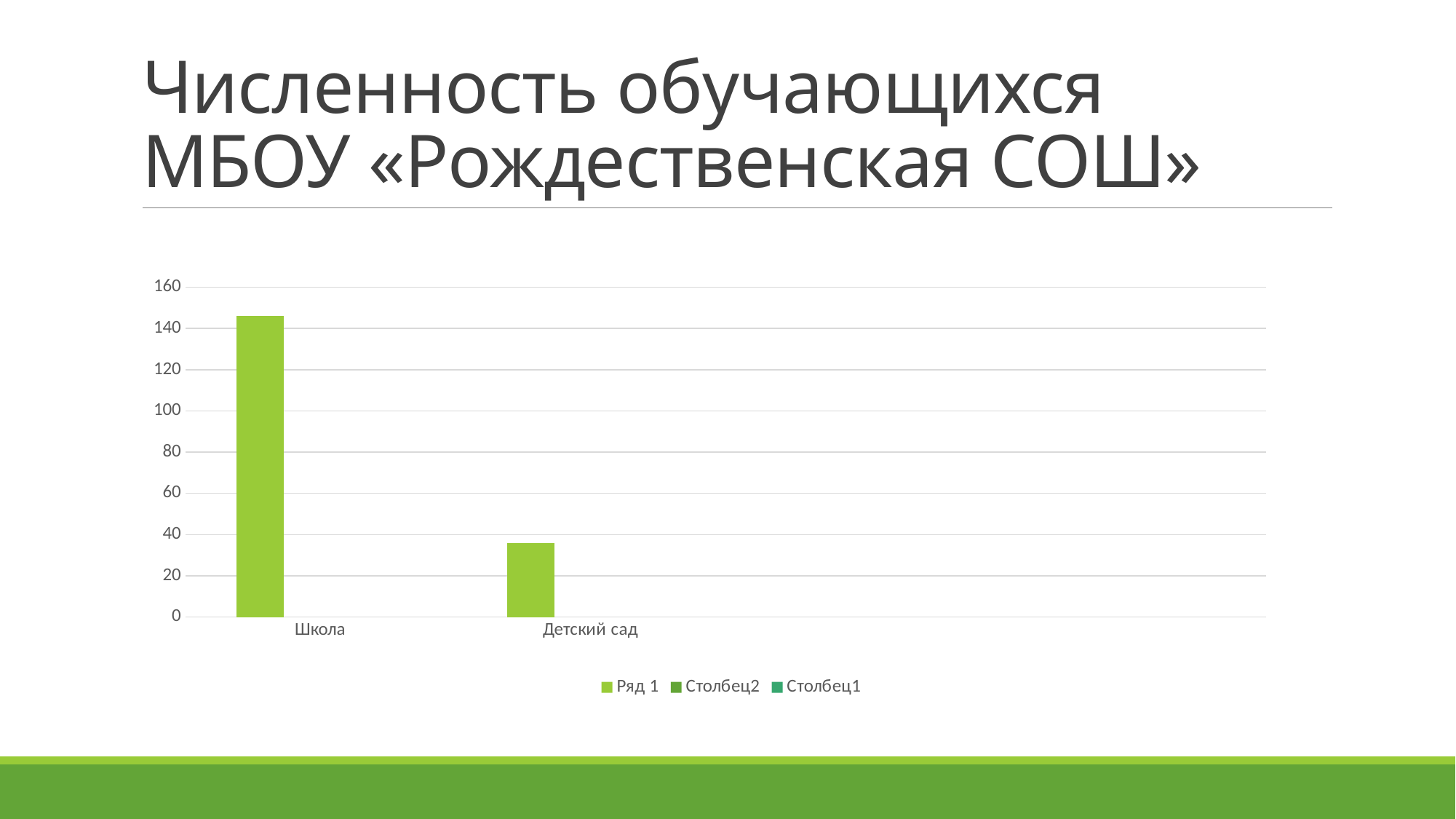
How many series does the chart legend list? 3 Which is larger, the value for Школа or the value for Детский сад? Школа What is the name of the first series listed in the chart legend? Ряд 1 Do the values fall or rise from Школа to Детский сад along the x axis? fall What is the title of the slide containing the chart? Численность обучающихся МБОУ «Рождественская СОШ» Is the value for Детский сад greater or less than 20? greater Which category has the lowest value in the chart? Детский сад How many categories are shown on the x axis of the chart? 2 Which category has the highest value in the chart? Школа What kind of chart is shown on the slide? bar chart Is the value for Детский сад greater or less than 40? less Is the value for Школа greater or less than 120? greater